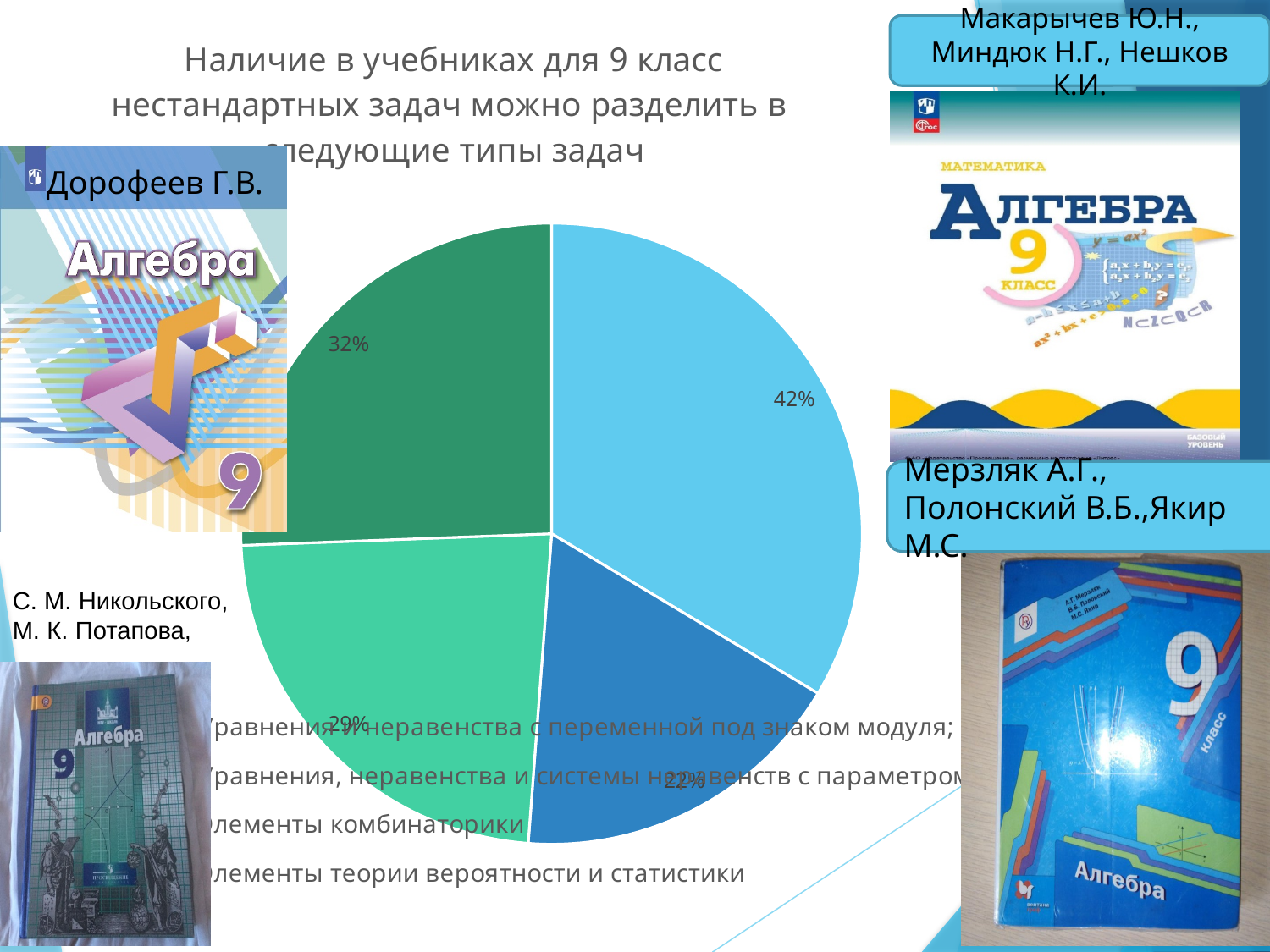
What value is labelled on the dark blue slice of the pie chart? 22% What is the largest percentage value labelled on the pie chart? 42% What is the difference in percentage points between the largest slice (42%) and the smallest slice (22%)? 20 What value is labelled on the light green slice of the pie chart? 29% What value is labelled on the light blue slice of the pie chart? 42% Which slice is larger, the dark green slice or the dark blue slice? the dark green slice Which legend entry mentions combinatorics (комбинаторики)? Элементы комбинаторики How many slices does the pie chart have? 4 How many entries does the legend below the pie chart list? 4 What is the smallest percentage value labelled on the pie chart? 22% What kind of chart is shown on the slide? pie chart What value is labelled on the dark green slice of the pie chart? 32%